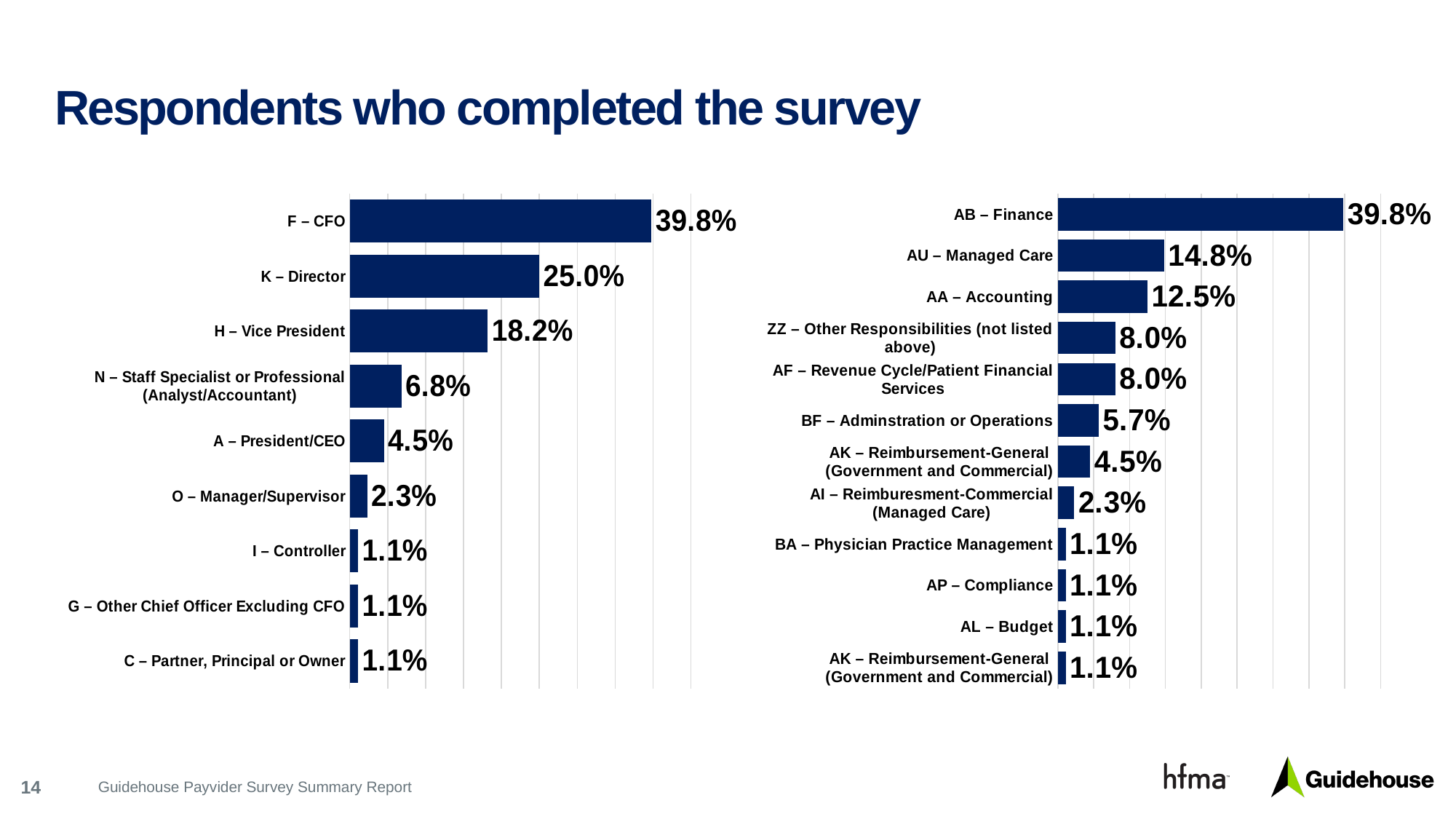
How many categories are shown on the right chart? 12 On the right chart, which category has the highest value? AB – Finance On the right chart, what is the value for BF – Adminstration or Operations? 5.7% How many categories are shown on the left chart? 9 On the left chart, which category has the highest value? F – CFO On the left chart, what is the value for N – Staff Specialist or Professional (Analyst/Accountant)? 6.8% On the left chart, what is the difference between the values for F – CFO and K – Director? 14.8% On the left chart, what is the value for K – Director? 25.0% On the right chart, what is the difference between the values for AU – Managed Care and AA – Accounting? 2.3% On the left chart, which is larger: the value for H – Vice President or the value for A – President/CEO? H – Vice President On the right chart, what is the value for AU – Managed Care? 14.8% What kind of chart is the left chart? Bar chart